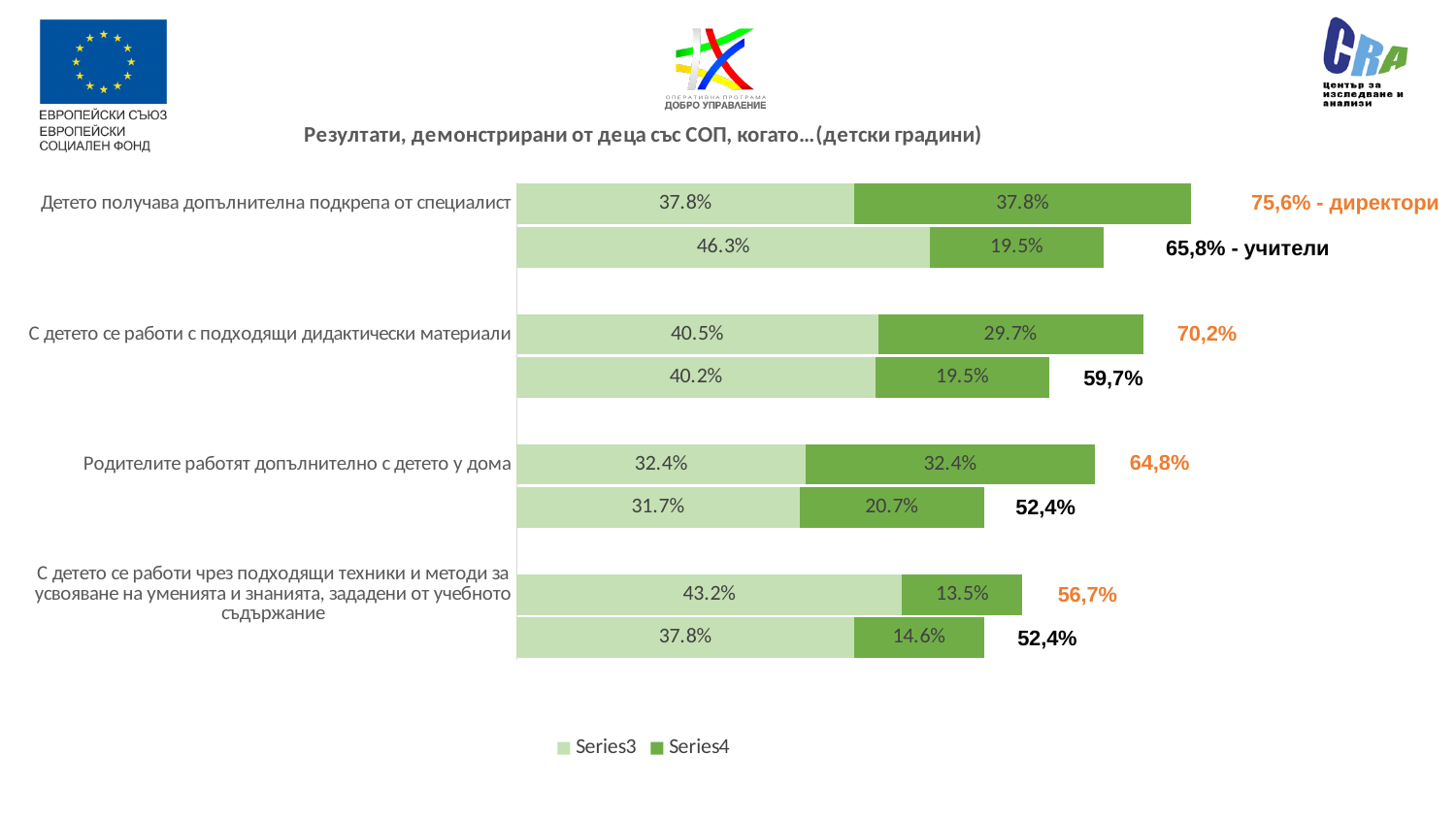
Which statement has the lowest total for directors? С детето се работи чрез подходящи техники и методи за усвояване на уменията и знанията, зададени от учебното съдържание How many series does the legend list? 2 How many categories (statements) are shown on the vertical axis of the chart? 4 What is the total shown for the directors' bar of "Детето получава допълнителна подкрепа от специалист"? 75,6% What is the total shown for the teachers' bar of "С детето се работи чрез подходящи техники и методи за усвояване на уменията и знанията, зададени от учебното съдържание"? 52,4% What is the Series3 value for the teachers' bar of "Родителите работят допълнително с детето у дома"? 31.7% For "Родителите работят допълнително с детето у дома", which is larger: the Series4 value for directors or the Series4 value for teachers? Directors (32.4%) What is the Series4 value for the teachers' bar of "С детето се работи с подходящи дидактически материали"? 19.5% What kind of chart is shown on the slide? Stacked bar chart What is the Series3 value for the directors' bar of "Детето получава допълнителна подкрепа от специалист"? 37.8% What is the difference between the directors' total and the teachers' total for "С детето се работи с подходящи дидактически материали"? 10,5% Which statement has the highest total for directors? Детето получава допълнителна подкрепа от специалист